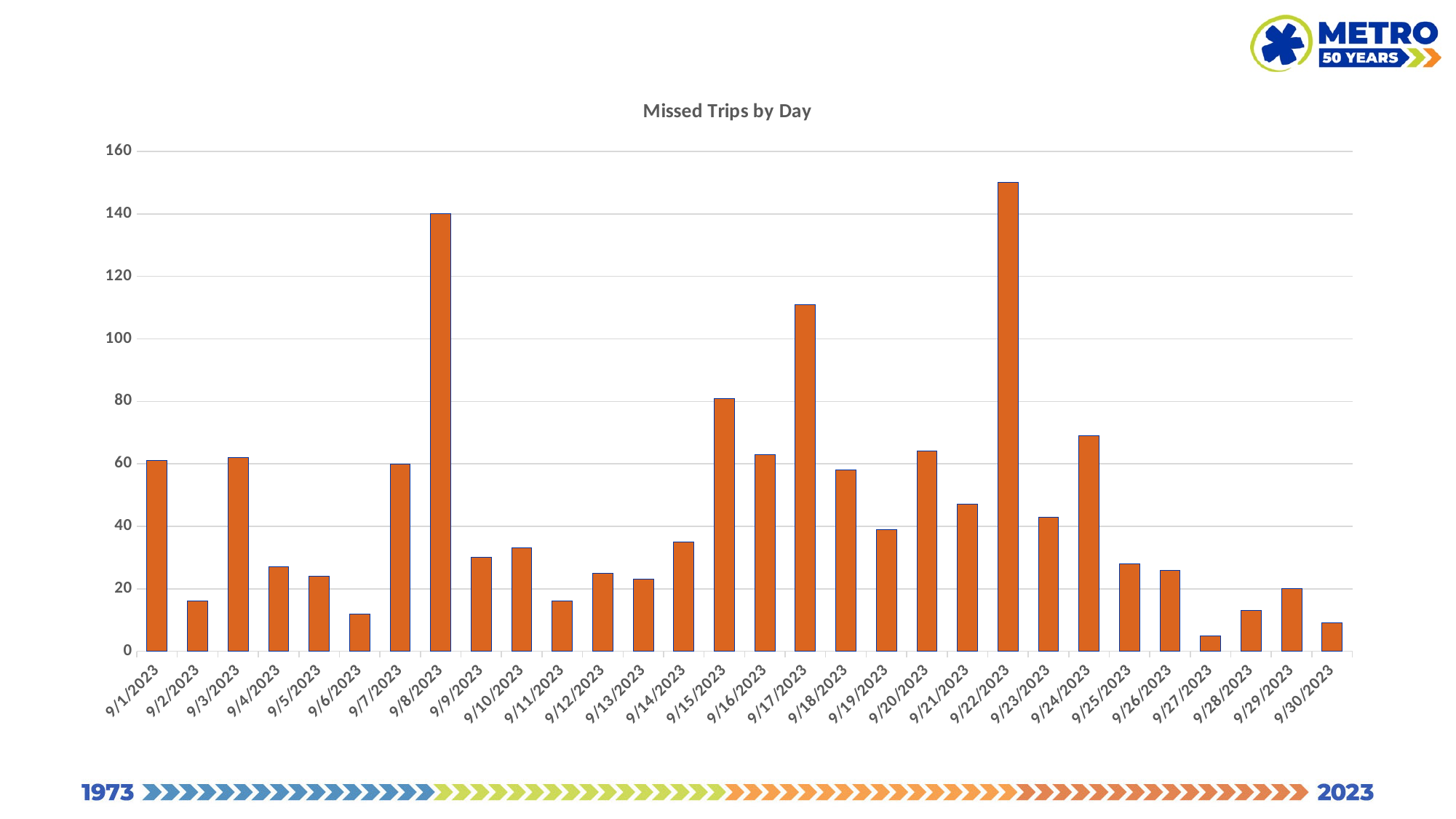
Is the value for 9/6/2023 greater or less than 20? less Which day has the lowest number of missed trips? 9/27/2023 Is the value for 9/17/2023 greater or less than 100? greater Which day has more missed trips, 9/1/2023 or 9/2/2023? 9/1/2023 How many days (bars) are plotted in the chart? 30 What is the title of the chart? Missed Trips by Day What kind of chart is shown on the slide? bar chart Which day has more missed trips, 9/8/2023 or 9/17/2023? 9/8/2023 Which day has the highest number of missed trips? 9/22/2023 Do the values rise or fall from 9/24/2023 to 9/27/2023? fall Is the value for 9/15/2023 greater or less than 60? greater